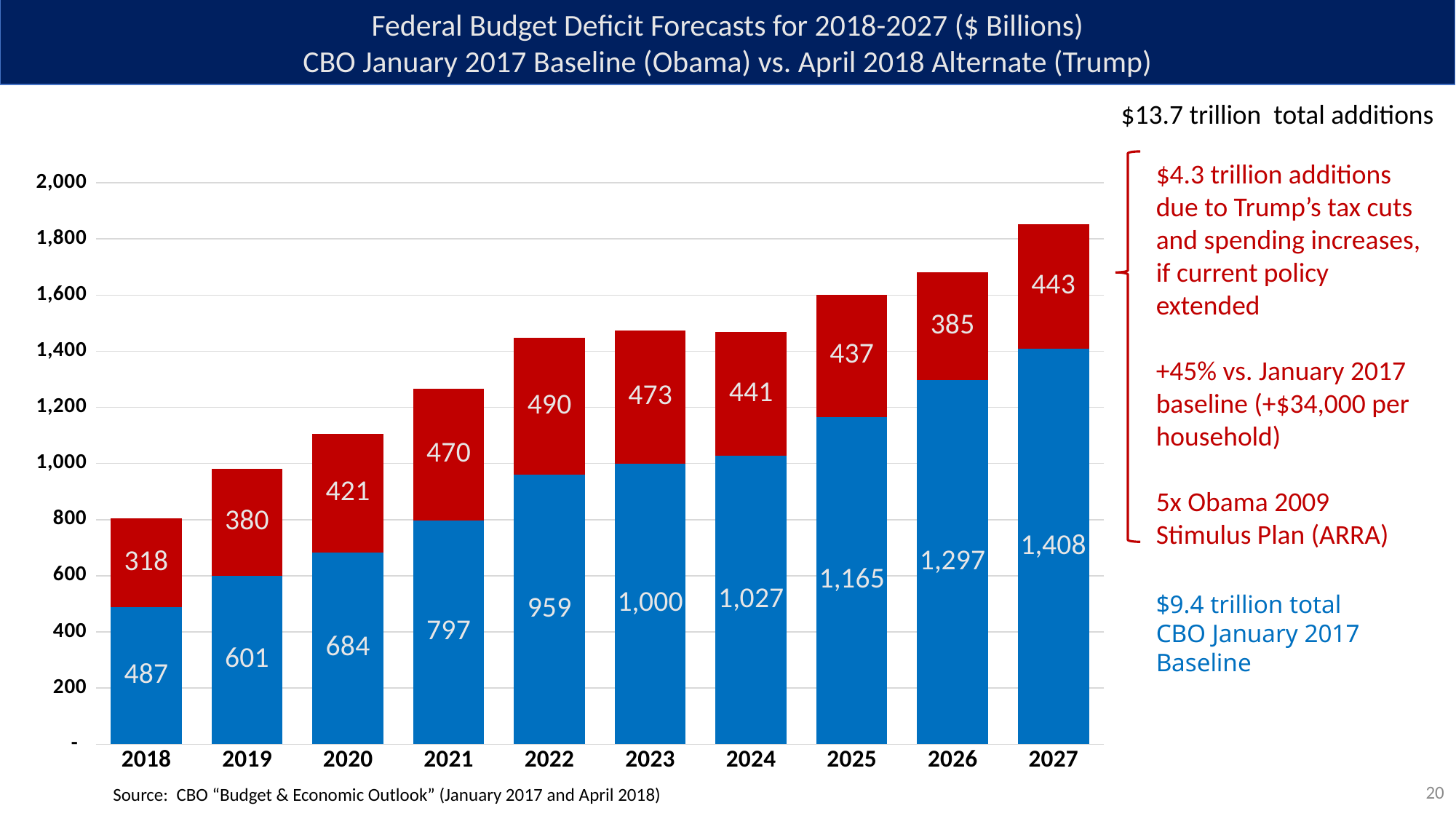
What is the value of the blue (baseline) segment for 2027? 1,408 Do the blue (baseline) segment values rise or fall from 2018 to 2027? rise What is the difference between the blue segment values for 2027 and 2026? 111 How many years are shown on the x axis? 10 What is the total height of the stacked bar for 2027? 1,851 Which year has the smallest blue (baseline) segment? 2018 Which year has the largest red (additions) segment? 2022 What type of chart is shown on the slide? stacked bar chart What is the value of the blue (baseline) segment for 2018? 487 Is the red segment for 2023 larger or smaller than the red segment for 2024? larger What is the value of the red (additions) segment for 2022? 490 What is the total height of the stacked bar for 2018? 805